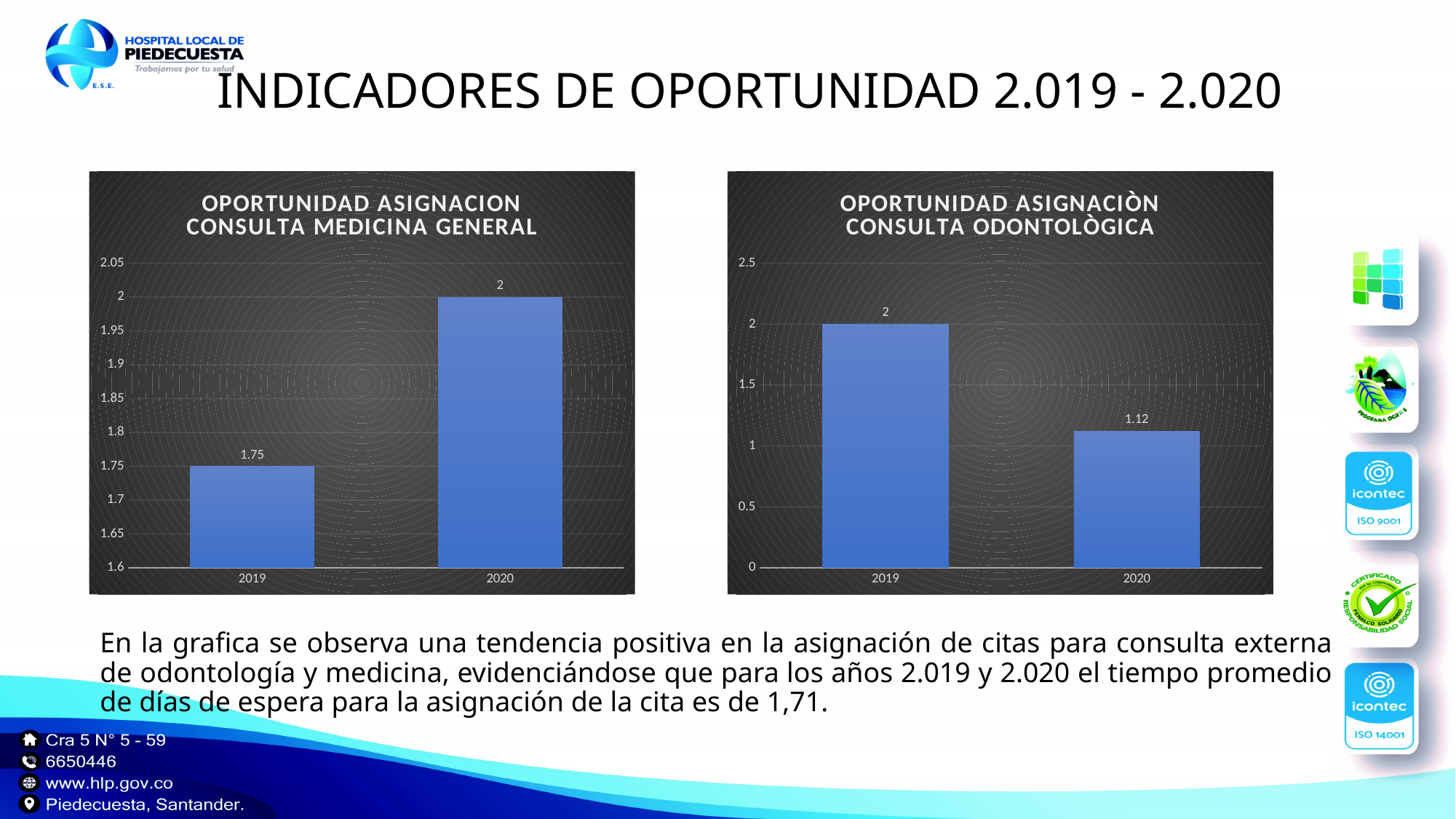
In the 'OPORTUNIDAD ASIGNACIÒN CONSULTA ODONTOLÒGICA' chart, what is the value for 2020? 1.12 In the 'OPORTUNIDAD ASIGNACION CONSULTA MEDICINA GENERAL' chart, what is the value for 2019? 1.75 In the 'OPORTUNIDAD ASIGNACION CONSULTA MEDICINA GENERAL' chart, which year has the highest value? 2020 In the 'OPORTUNIDAD ASIGNACIÒN CONSULTA ODONTOLÒGICA' chart, what is the difference between the 2019 and 2020 values? 0.88 In the 'OPORTUNIDAD ASIGNACION CONSULTA MEDICINA GENERAL' chart, what is the difference between the 2020 and 2019 values? 0.25 In the 'OPORTUNIDAD ASIGNACIÒN CONSULTA ODONTOLÒGICA' chart, which year has the lowest value? 2020 In the 'OPORTUNIDAD ASIGNACIÒN CONSULTA ODONTOLÒGICA' chart, which year has the larger value, 2019 or 2020? 2019 In the 'OPORTUNIDAD ASIGNACION CONSULTA MEDICINA GENERAL' chart, what is the value for 2020? 2 In the 'OPORTUNIDAD ASIGNACION CONSULTA MEDICINA GENERAL' chart, do the values rise or fall from 2019 to 2020? rise What kind of chart is the 'OPORTUNIDAD ASIGNACION CONSULTA MEDICINA GENERAL' chart? bar chart How many categories are shown on the x axis of the 'OPORTUNIDAD ASIGNACIÒN CONSULTA ODONTOLÒGICA' chart? 2 In the 'OPORTUNIDAD ASIGNACIÒN CONSULTA ODONTOLÒGICA' chart, what is the value for 2019? 2